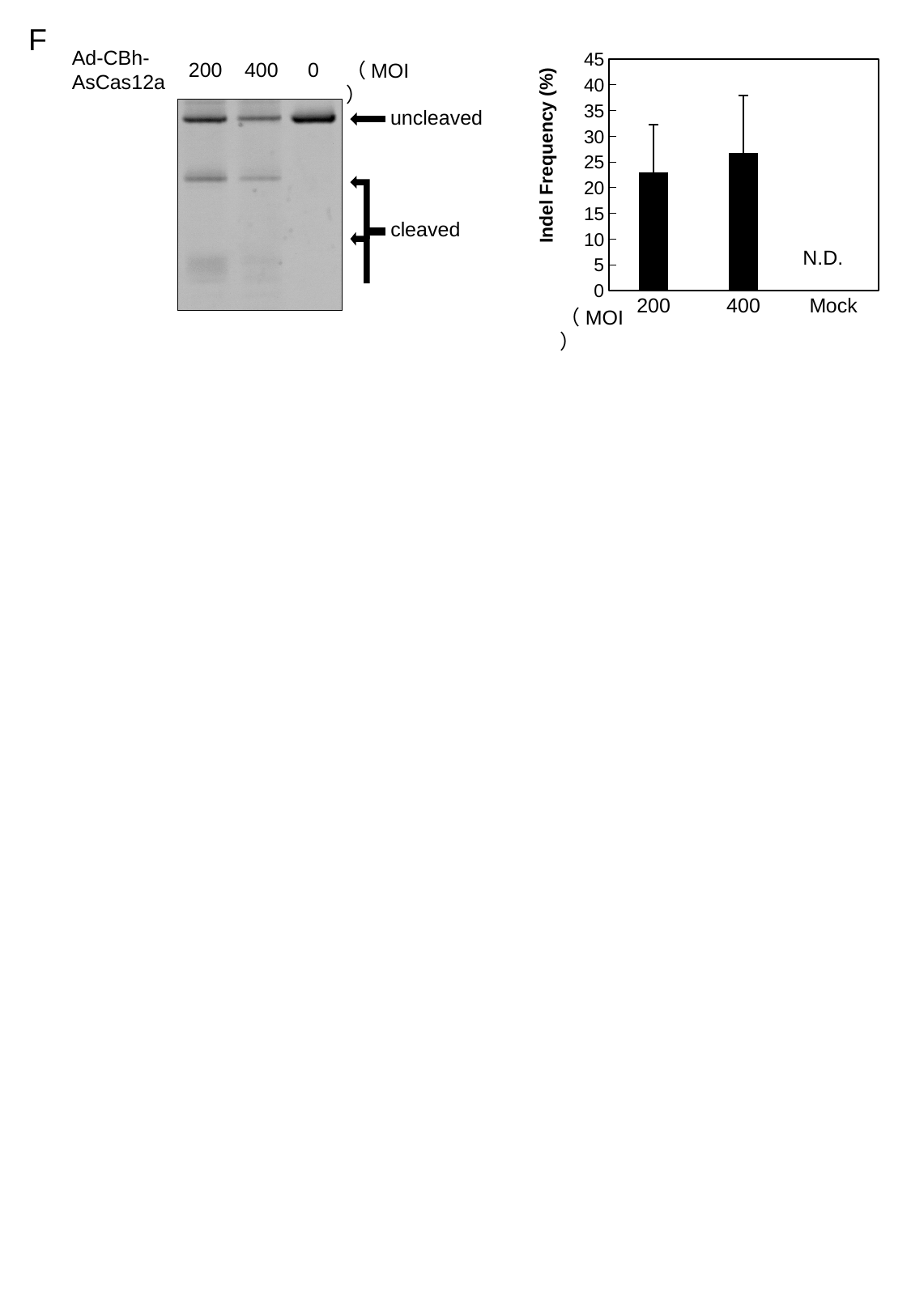
What is the y-axis label of the bar chart? Indel Frequency (%) What is the highest value shown on the y axis of the bar chart? 45 Is the indel frequency for MOI 400 greater or less than 20? greater How many categories are shown on the x axis of the bar chart? 3 What kind of chart is shown on the right side of the slide? bar chart Is the indel frequency for MOI 400 greater or less than 30? less What is shown for the Mock category in the bar chart? N.D. Which has the higher indel frequency, MOI 200 or MOI 400? 400 Which category in the bar chart has the highest indel frequency? 400 Is the indel frequency for MOI 200 greater or less than 30? less